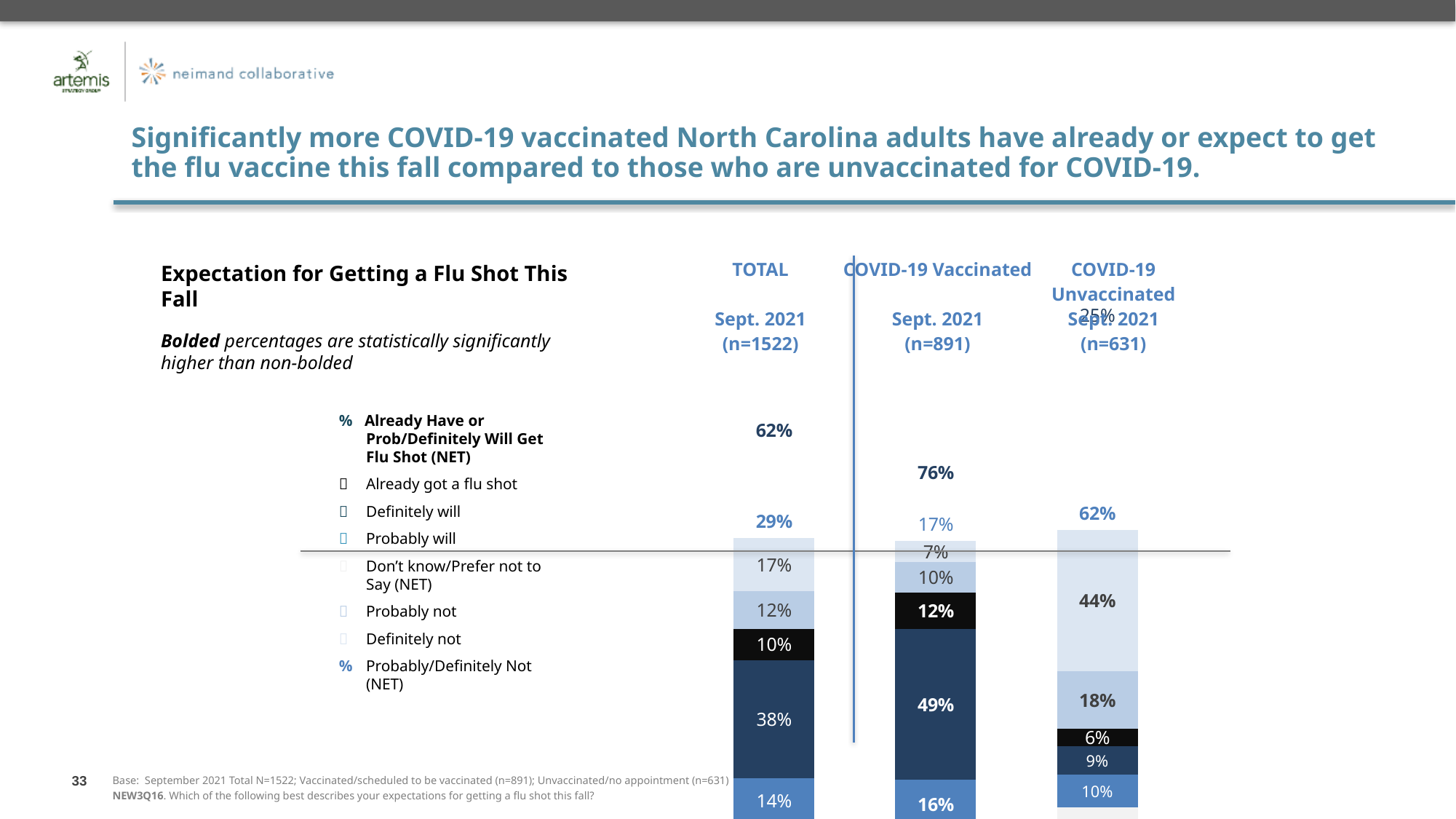
What is the 'Already Have or Prob/Definitely Will Get Flu Shot (NET)' percentage for the Total column? 62% What is the 'Probably/Definitely Not (NET)' percentage for COVID-19 Vaccinated adults? 17% What is the 'Probably/Definitely Not (NET)' percentage for COVID-19 Unvaccinated adults? 62% What is the largest segment value shown in the COVID-19 Vaccinated bar? 49% What is the 'Already Have or Prob/Definitely Will Get Flu Shot (NET)' percentage for COVID-19 Vaccinated adults? 76% What is the 'Probably/Definitely Not (NET)' percentage for the Total column? 29% Which group has the higher 'Already Have or Prob/Definitely Will Get Flu Shot (NET)' percentage, COVID-19 Vaccinated or Total? COVID-19 Vaccinated What type of chart is used to show the flu shot expectations? Stacked bar chart How many bars (groups) are shown in the chart? 3 What is the sample size (n) for the COVID-19 Unvaccinated group? 631 What is the difference between the 'Probably/Definitely Not (NET)' percentages for COVID-19 Unvaccinated and COVID-19 Vaccinated adults? 45 percentage points What is the largest segment value shown in the COVID-19 Unvaccinated bar? 44%